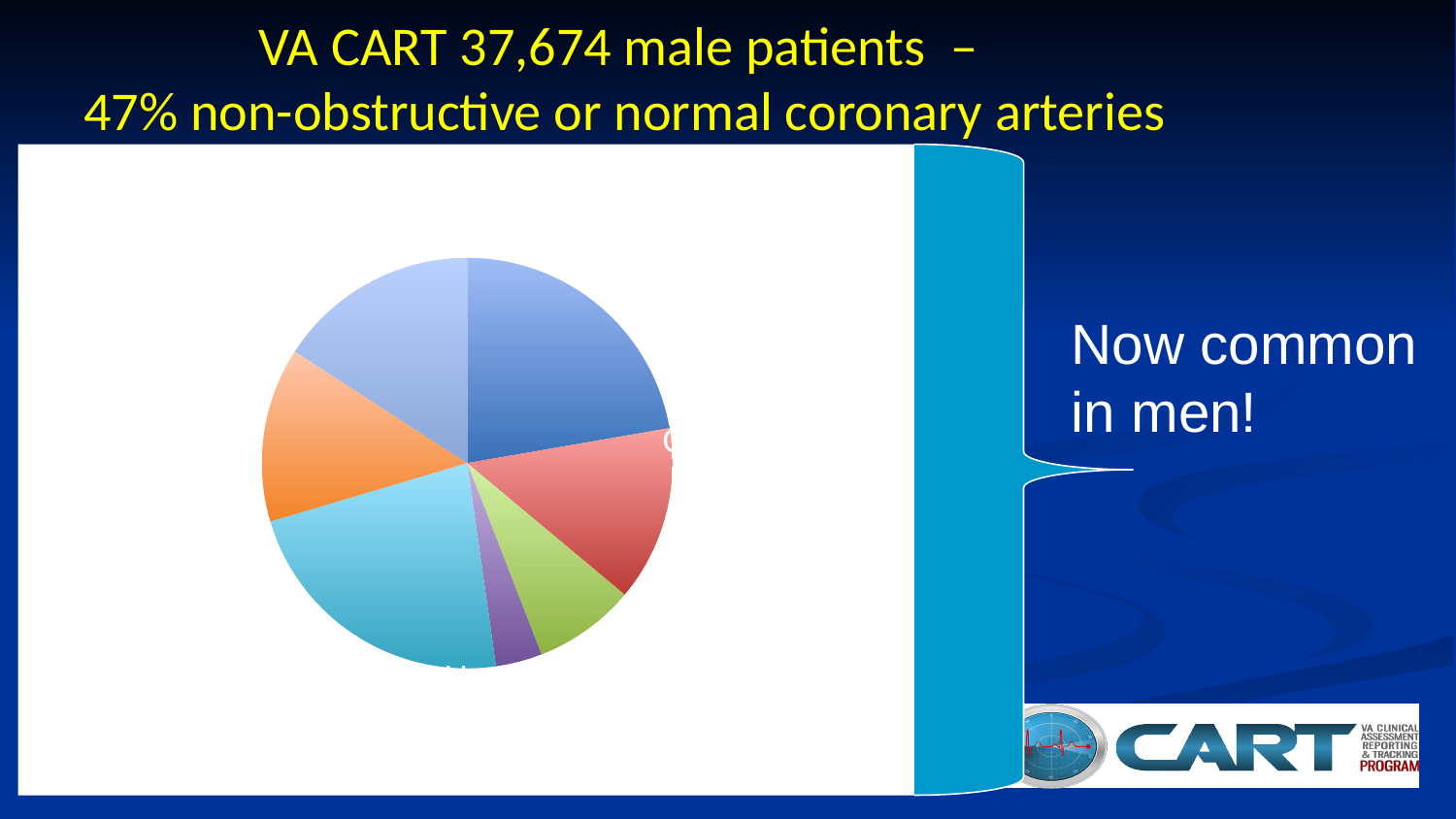
What kind of chart is shown on the slide? pie chart Is the purple slice of the pie chart larger or smaller than the green slice? smaller Which colour slice of the pie chart is the smallest? purple Does the pie chart display a legend? No How many slices does the pie chart have? 7